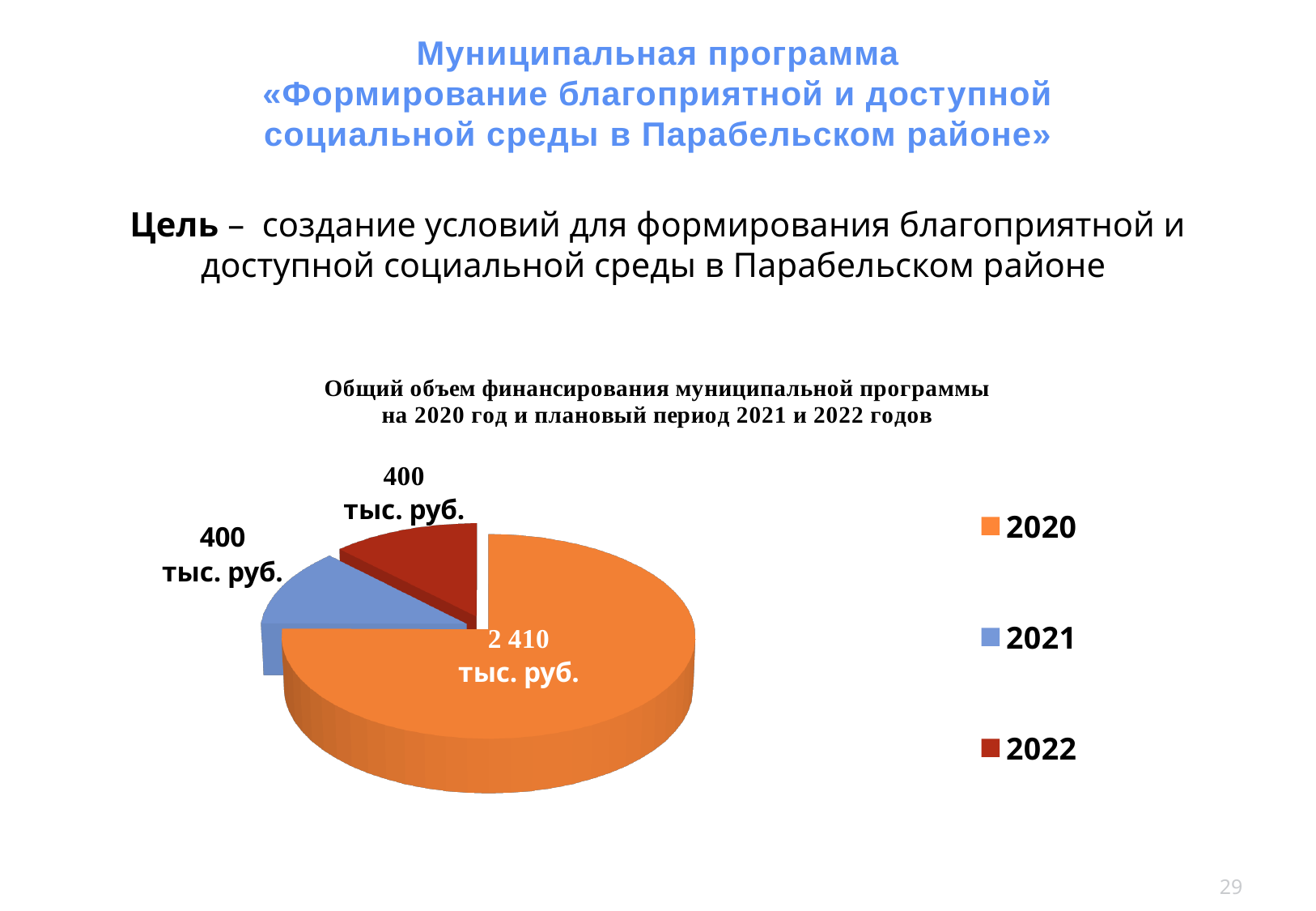
What is the difference between the values for 2020 and 2022? 2 010 тыс. руб. Which is larger, the value for 2020 or the value for 2021? 2020 What is the funding value for 2022? 400 тыс. руб. What is the funding value for 2020? 2 410 тыс. руб. What kind of chart is shown on the slide? Pie chart How many entries does the legend list? 3 How many slices does the pie chart have? 3 What is the title of the chart? Общий объем финансирования муниципальной программы на 2020 год и плановый период 2021 и 2022 годов What is the funding value for 2021? 400 тыс. руб. Which year has the largest slice of the pie? 2020 What is the total of all three slices of the pie? 3 210 тыс. руб. What colour is the slice for 2020? Orange